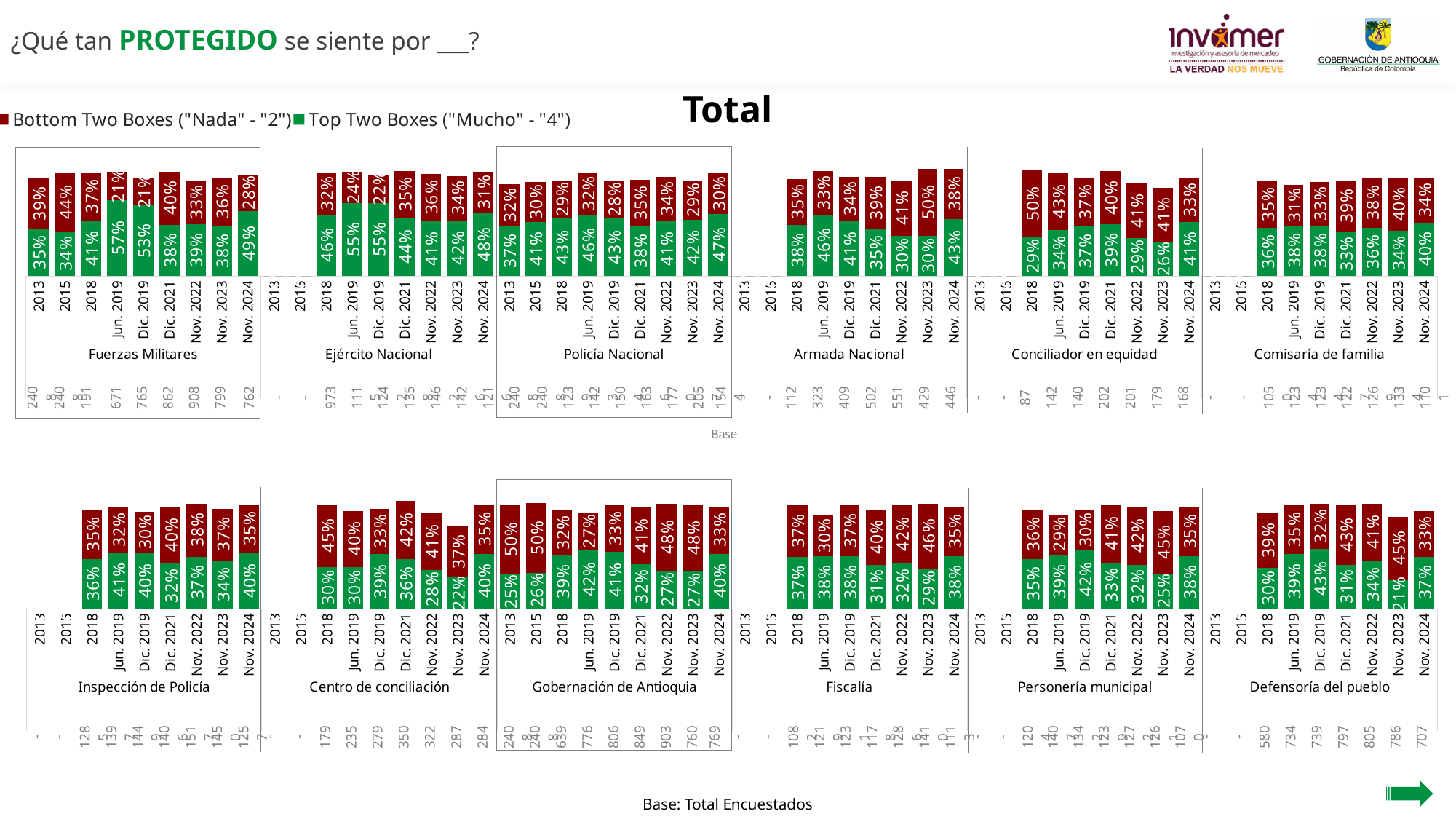
In the Centro de conciliación chart, what is the Top Two Boxes value for Nov. 2023? 22% In the Defensoría del pueblo chart, what is the Bottom Two Boxes value for Nov. 2023? 45% In the Fuerzas Militares chart, which period has the highest Top Two Boxes value? Jun. 2019 In the Personería municipal chart, what is the Top Two Boxes value for Dic. 2019? 42% In the Fuerzas Militares chart, what is the difference between the Top Two Boxes and Bottom Two Boxes values for Jun. 2019? 36 percentage points In the Fuerzas Militares chart, what is the Top Two Boxes value for Jun. 2019? 57% In the Defensoría del pueblo chart, which period has the lowest Top Two Boxes value? Nov. 2023 In the Fuerzas Militares chart, what is the combined total of the Top Two Boxes and Bottom Two Boxes values for Jun. 2019? 78% How many series does the legend list? 2 In the Gobernación de Antioquia chart, what is the Bottom Two Boxes value for 2013? 50% What kind of chart is used for each institution on the slide? Stacked bar chart In the Armada Nacional chart, which is larger for Nov. 2023: the Bottom Two Boxes value or the Top Two Boxes value? Bottom Two Boxes